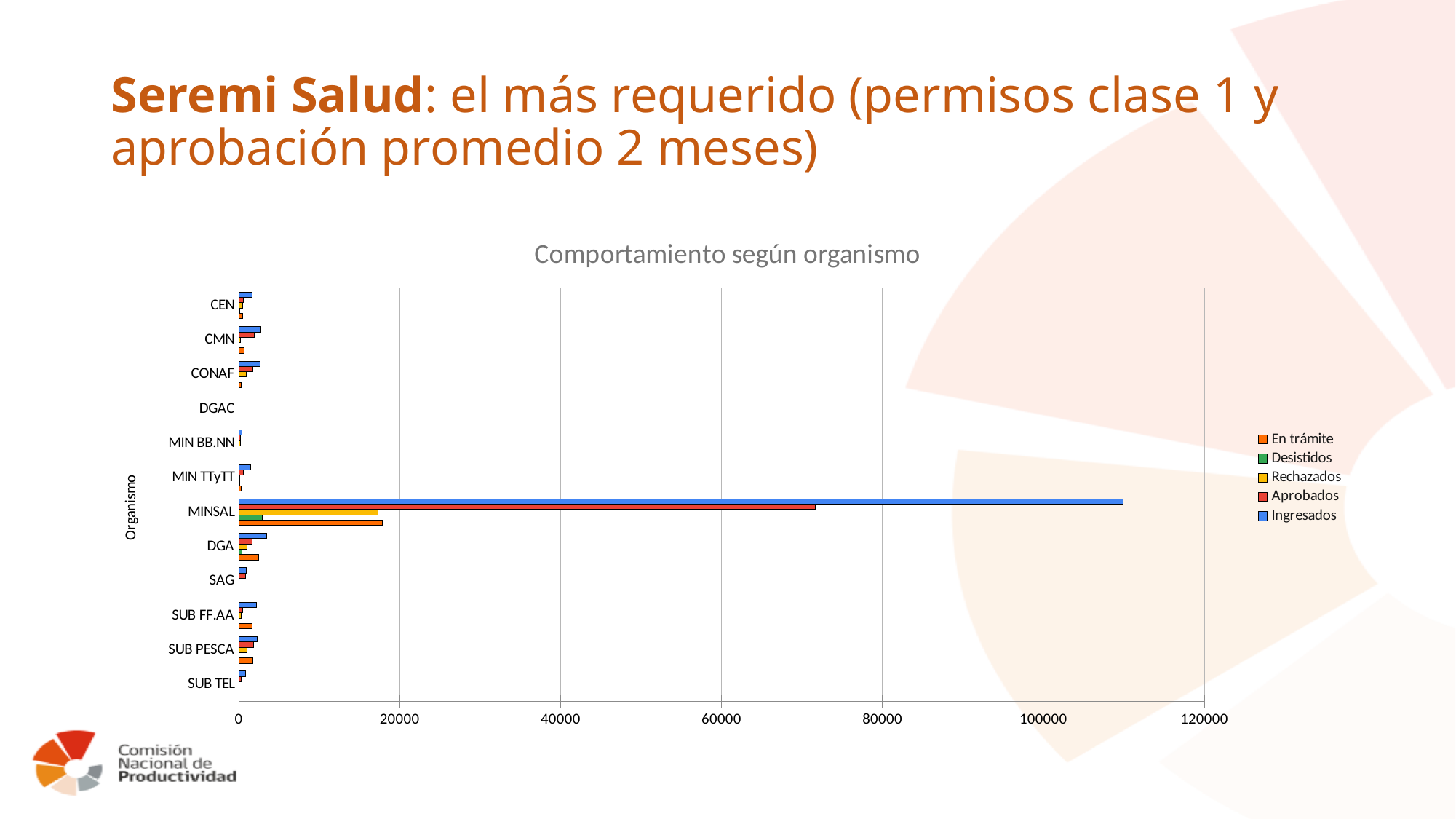
What is the title of the chart? Comportamiento según organismo What kind of chart is shown on the slide? Bar chart For MINSAL, which is larger: Ingresados or Aprobados? Ingresados Which organism has the highest value for Ingresados? MINSAL How many series does the chart legend list? 5 Is the Ingresados value for MINSAL greater or less than 100000? greater Which organism has the highest value for Aprobados? MINSAL Is the Rechazados value for MINSAL greater or less than 20000? less Is the Aprobados value for MINSAL greater or less than 60000? greater How many organisms (categories) are shown on the vertical axis of the chart? 12 What is the label on the vertical axis of the chart? Organismo